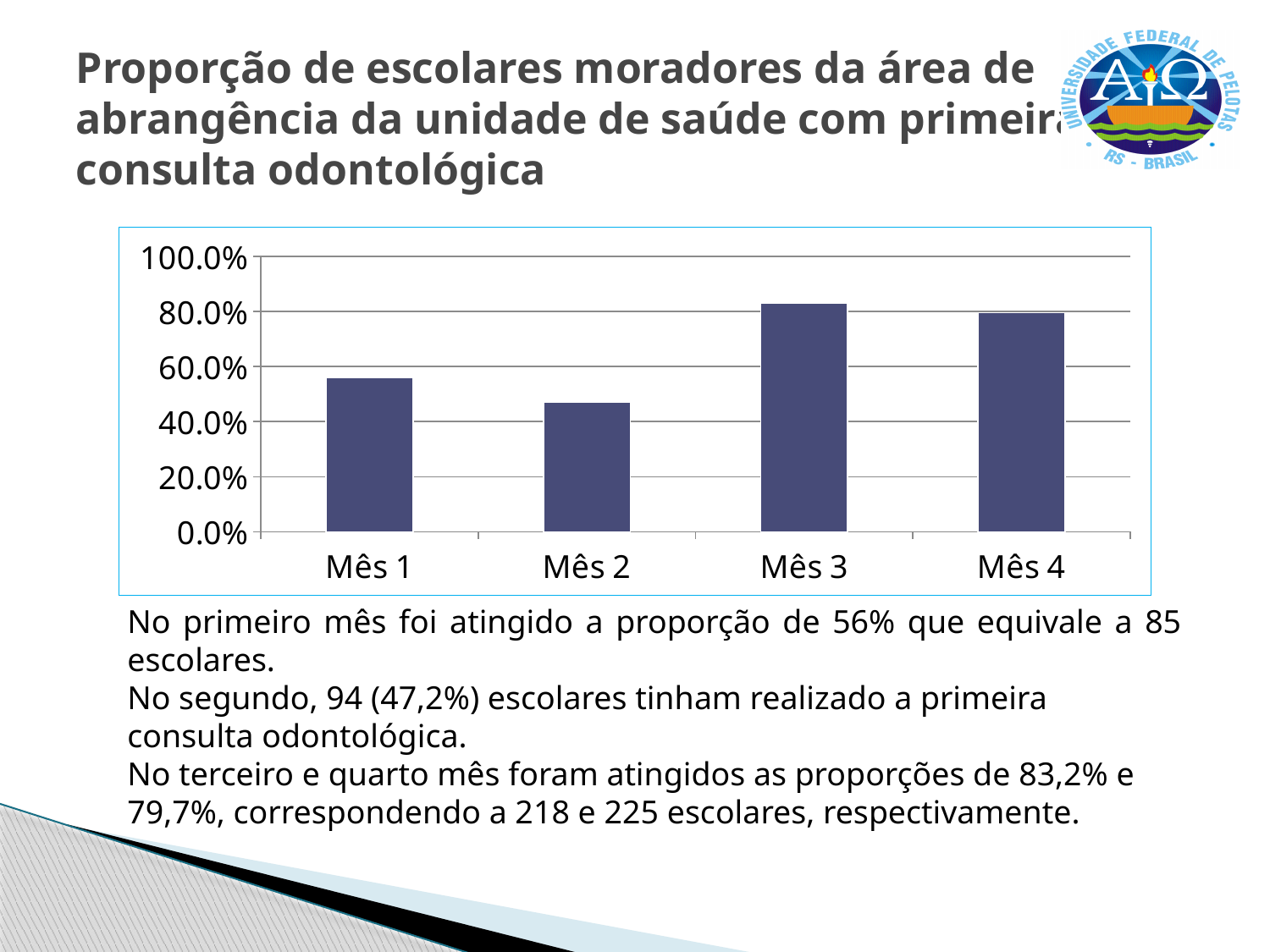
Is the value for Mês 2 greater or less than 60.0%? less What kind of chart is shown on the slide? bar chart Does the value rise or fall from Mês 2 to Mês 3? rise Which is larger, the value for Mês 3 or the value for Mês 4? Mês 3 Which is larger, the value for Mês 1 or the value for Mês 2? Mês 1 Which month has the lowest bar in the chart? Mês 2 Which month has the highest bar in the chart? Mês 3 Is the value for Mês 4 greater or less than 100.0%? less What is the highest tick value shown on the y axis of the chart? 100.0% How many categories (months) are shown on the x axis of the chart? 4 Is the value for Mês 1 greater or less than 40.0%? greater